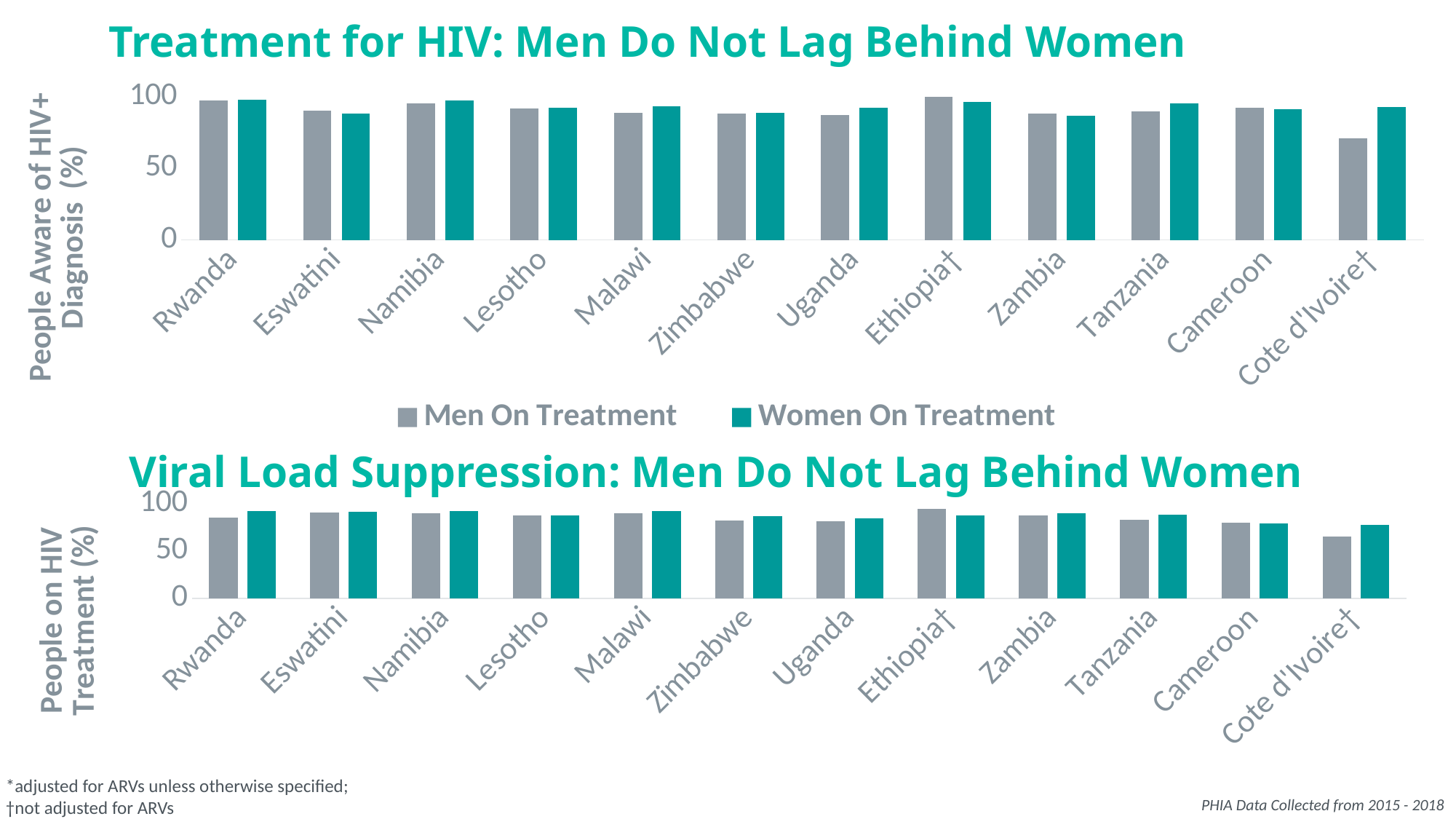
What is the y-axis label of the bottom chart, 'Viral Load Suppression'? People on HIV Treatment (%) Which colour represents Women On Treatment in the legend? Teal In the top chart, 'Treatment for HIV', which country has the lowest value for Men On Treatment? Cote d'Ivoire† How many series does the legend list for the charts on this slide? 2 In the top chart, 'Treatment for HIV', is the Men On Treatment value for Cote d'Ivoire† greater or less than 50? greater In the bottom chart, 'Viral Load Suppression', which country has the lowest value for Men On Treatment? Cote d'Ivoire† In the top chart, 'Treatment for HIV', which is larger for Cote d'Ivoire†: Men On Treatment or Women On Treatment? Women On Treatment In the bottom chart, 'Viral Load Suppression', which is larger for Cote d'Ivoire†: Men On Treatment or Women On Treatment? Women On Treatment How many countries are shown on the x axis of the top chart, 'Treatment for HIV: Men Do Not Lag Behind Women'? 12 What kind of chart is the top chart titled 'Treatment for HIV: Men Do Not Lag Behind Women'? Bar chart In the bottom chart, 'Viral Load Suppression', is the Women On Treatment value for Rwanda greater or less than 50? greater In the bottom chart, 'Viral Load Suppression', is the Men On Treatment value for Cote d'Ivoire† greater or less than 50? greater